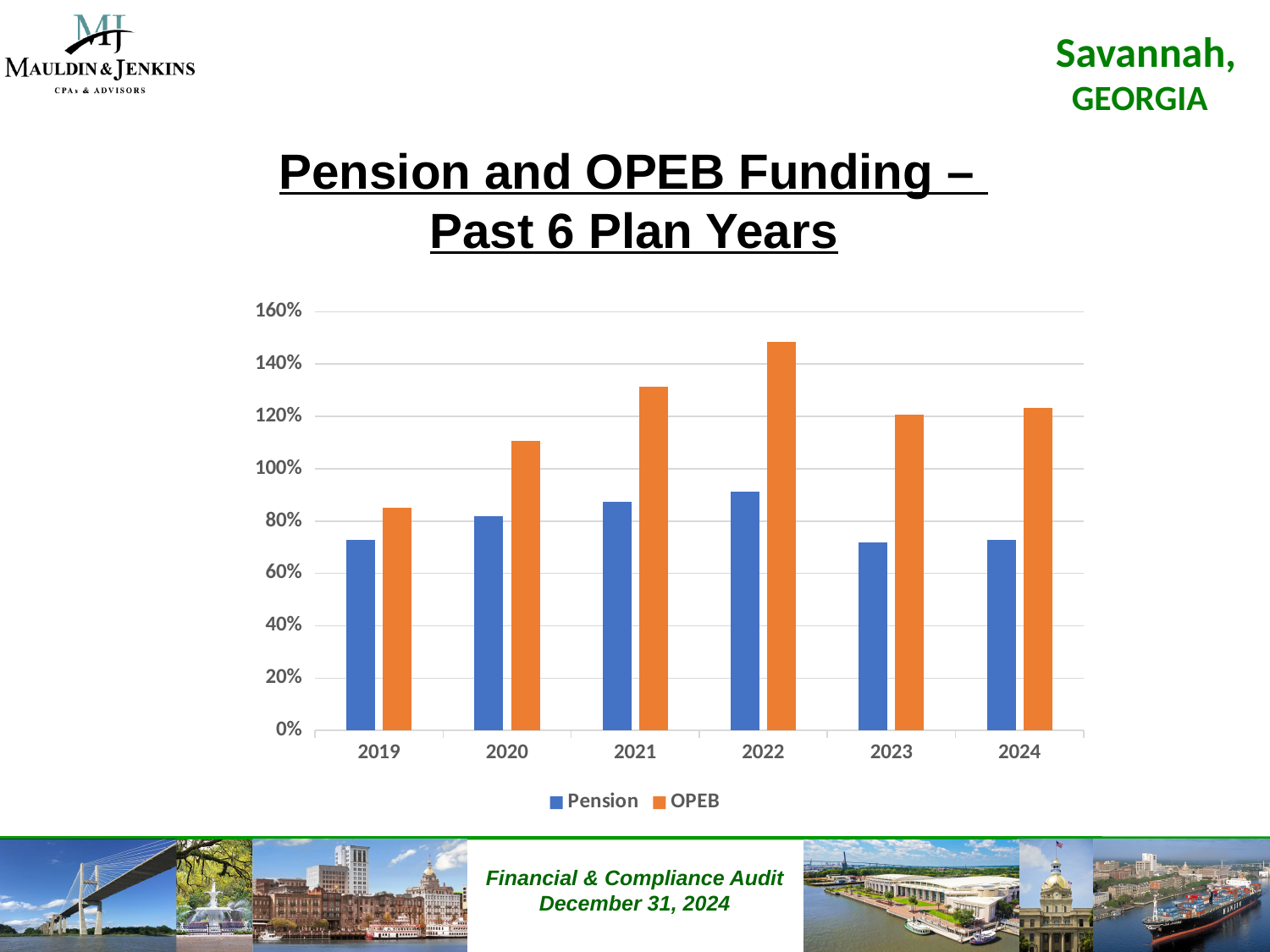
How many series does the legend list? 2 How many plan years are shown on the x axis? 6 Is the Pension value for 2022 greater or less than 80%? greater Which series is shown in orange in the legend? OPEB Which year has the highest OPEB funding value? 2022 Is the OPEB value for 2020 greater or less than 100%? greater In 2021, which is larger, the Pension value or the OPEB value? OPEB What kind of chart is shown on the slide? bar chart Which is larger, the Pension value for 2020 or the Pension value for 2023? 2020 Is the OPEB value for 2022 greater or less than 140%? greater Which year has the lowest OPEB funding value? 2019